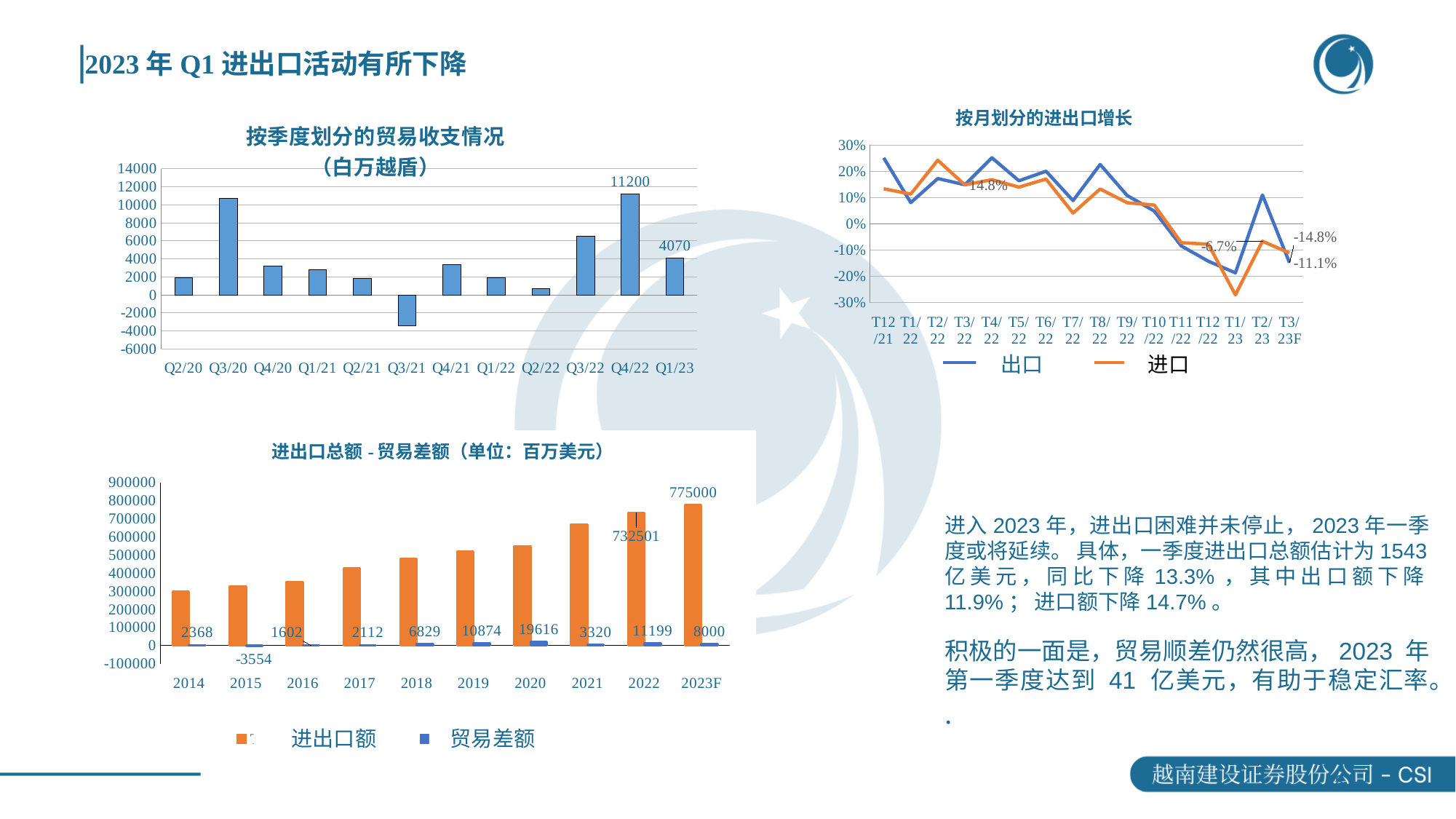
In the chart titled 按季度划分的贸易收支情况, what is the value for Q1/23? 4070 What kind of chart is the one titled 按月划分的进出口增长? line chart How many series does the legend of the chart titled 按月划分的进出口增长 list? 2 In the chart titled 按季度划分的贸易收支情况, what is the difference between the Q4/22 and Q1/23 values? 7130 In the chart titled 进出口总额 - 贸易差额, what is the difference between the 进出口额 values for 2023F and 2022? 42499 In the chart titled 进出口总额 - 贸易差额, which year has the lowest 贸易差额? 2015 In the chart titled 按季度划分的贸易收支情况, is the value for Q3/20 greater or less than 10000? greater In the chart titled 进出口总额 - 贸易差额, which year has the highest 贸易差额? 2020 In the chart titled 进出口总额 - 贸易差额, what is the 贸易差额 value for 2020? 19616 In the chart titled 进出口总额 - 贸易差额, does the 进出口额 series rise or fall from 2014 to 2023F? rise In the chart titled 按季度划分的贸易收支情况, how many quarters are shown on the x axis? 12 In the chart titled 按季度划分的贸易收支情况, what is the value for Q4/22? 11200